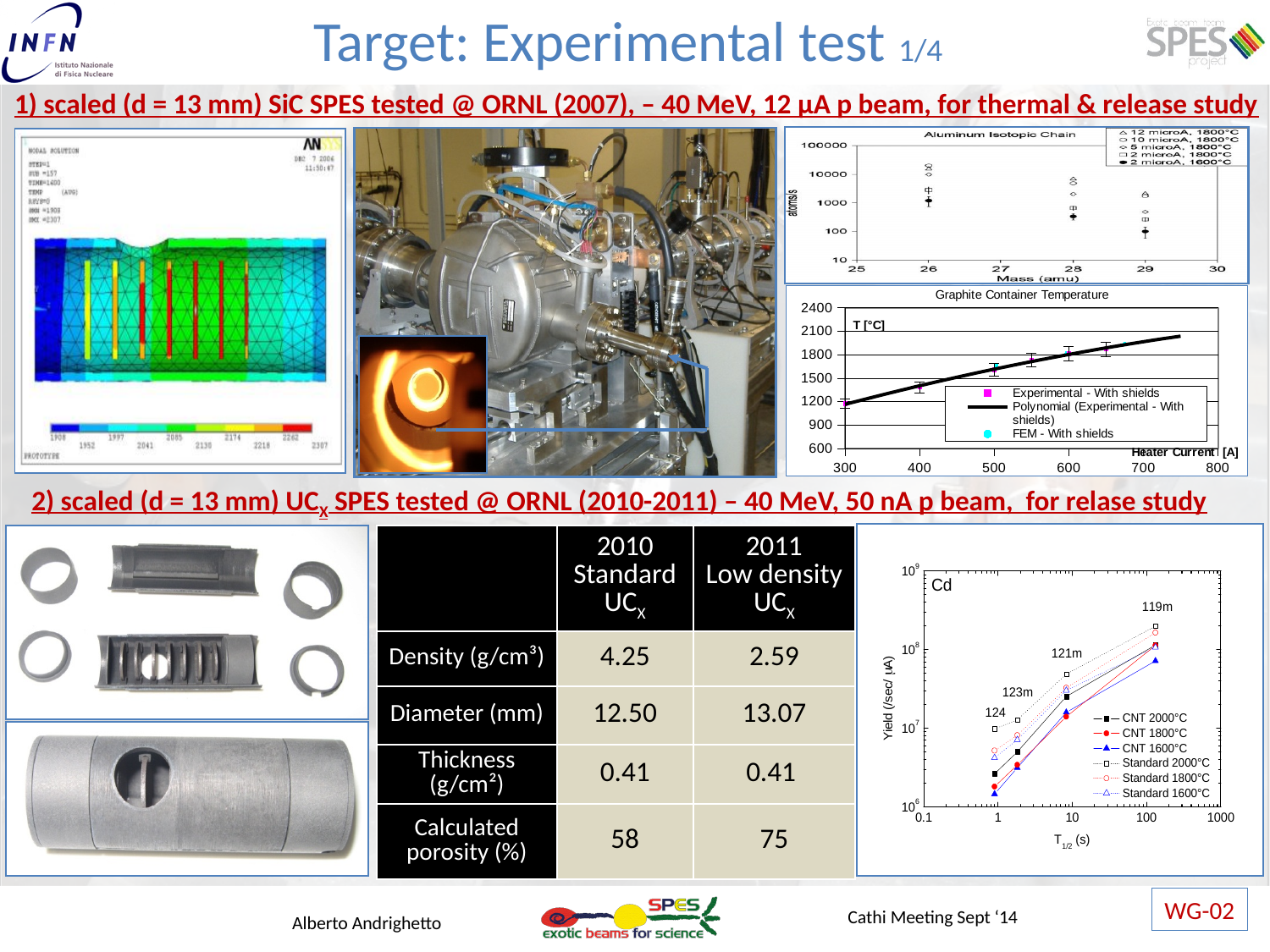
In the Cd yield chart at the bottom right, how many series does the legend list? 6 In the Aluminum Isotopic Chain chart, what is the label of the x axis? Mass (amu) In the Graphite Container Temperature chart, is the experimental temperature at a heater current of 300 A greater or less than 1500? less In the Cd yield chart at the bottom right, how many isotopes are labelled on the plot? 4 In the Graphite Container Temperature chart, how many entries does the legend list? 3 In the Cd yield chart at the bottom right, does the yield rise or fall as the half-life T1/2 increases? rise In the Graphite Container Temperature chart, is the experimental temperature at a heater current of 650 A greater or less than 2100? less What is the title of the chart at the top right of the slide showing atoms/s versus Mass (amu)? Aluminum Isotopic Chain In the Graphite Container Temperature chart, is the experimental temperature at a heater current of 400 A greater or less than 1200? greater In the Graphite Container Temperature chart, does the temperature rise or fall as the heater current increases? rise In the Graphite Container Temperature chart, what is the highest value shown on the temperature axis? 2400 In the Aluminum Isotopic Chain chart, how many series does the legend list? 5